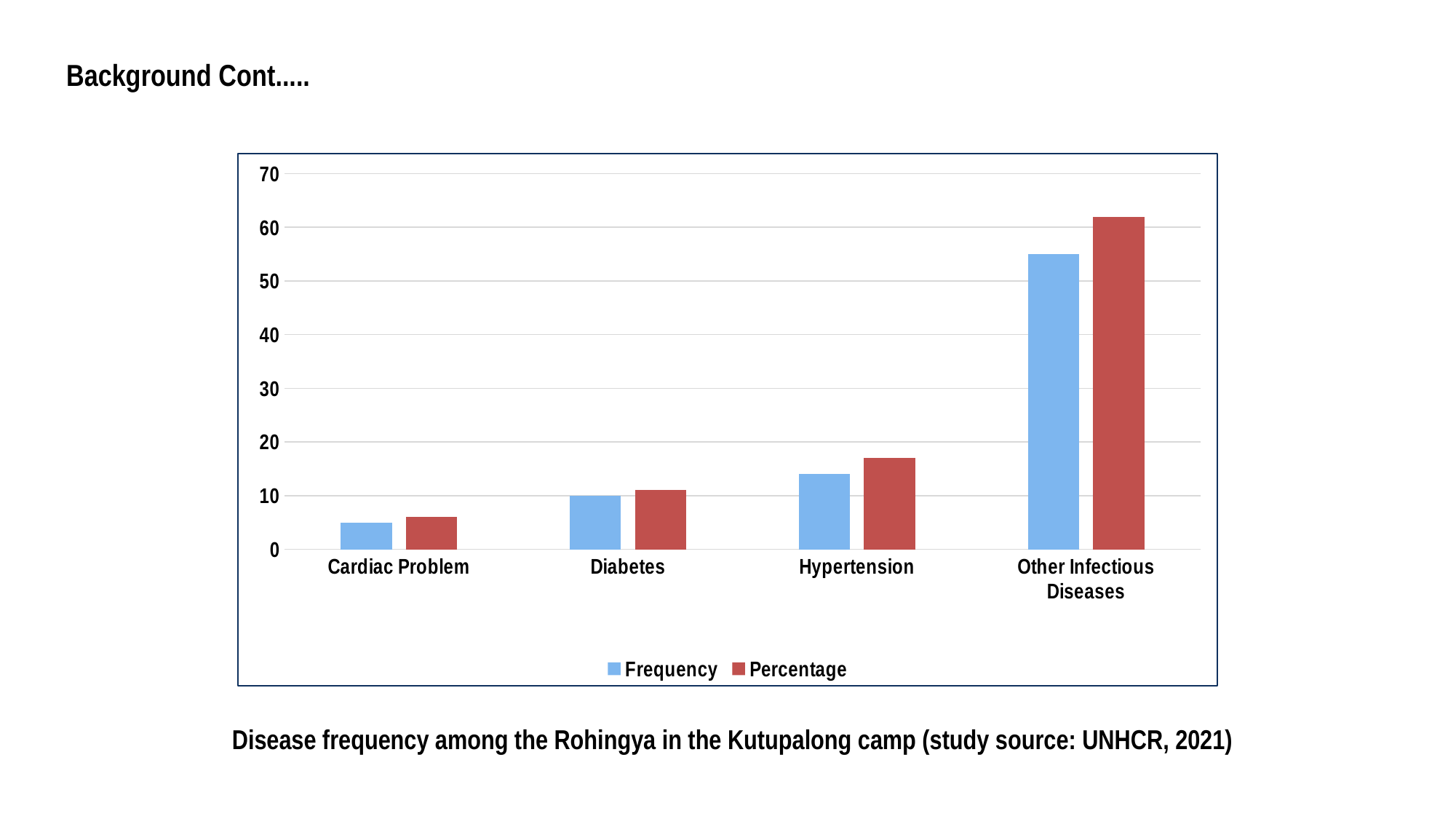
Which category has the highest Frequency? Other Infectious Diseases Which category has the lowest Percentage? Cardiac Problem Is the Percentage for Hypertension greater or less than 20? less Which is larger, the Frequency for Hypertension or the Frequency for Diabetes? Frequency for Hypertension Is the Frequency for Other Infectious Diseases greater or less than 50? greater Is the Percentage for Other Infectious Diseases greater or less than 60? greater How many series does the legend list? 2 Do the Frequency values rise or fall moving from Cardiac Problem to Other Infectious Diseases along the x axis? rise Which series is shown in red in the legend? Percentage How many disease categories are shown on the x axis? 4 What kind of chart is shown on the slide? bar chart